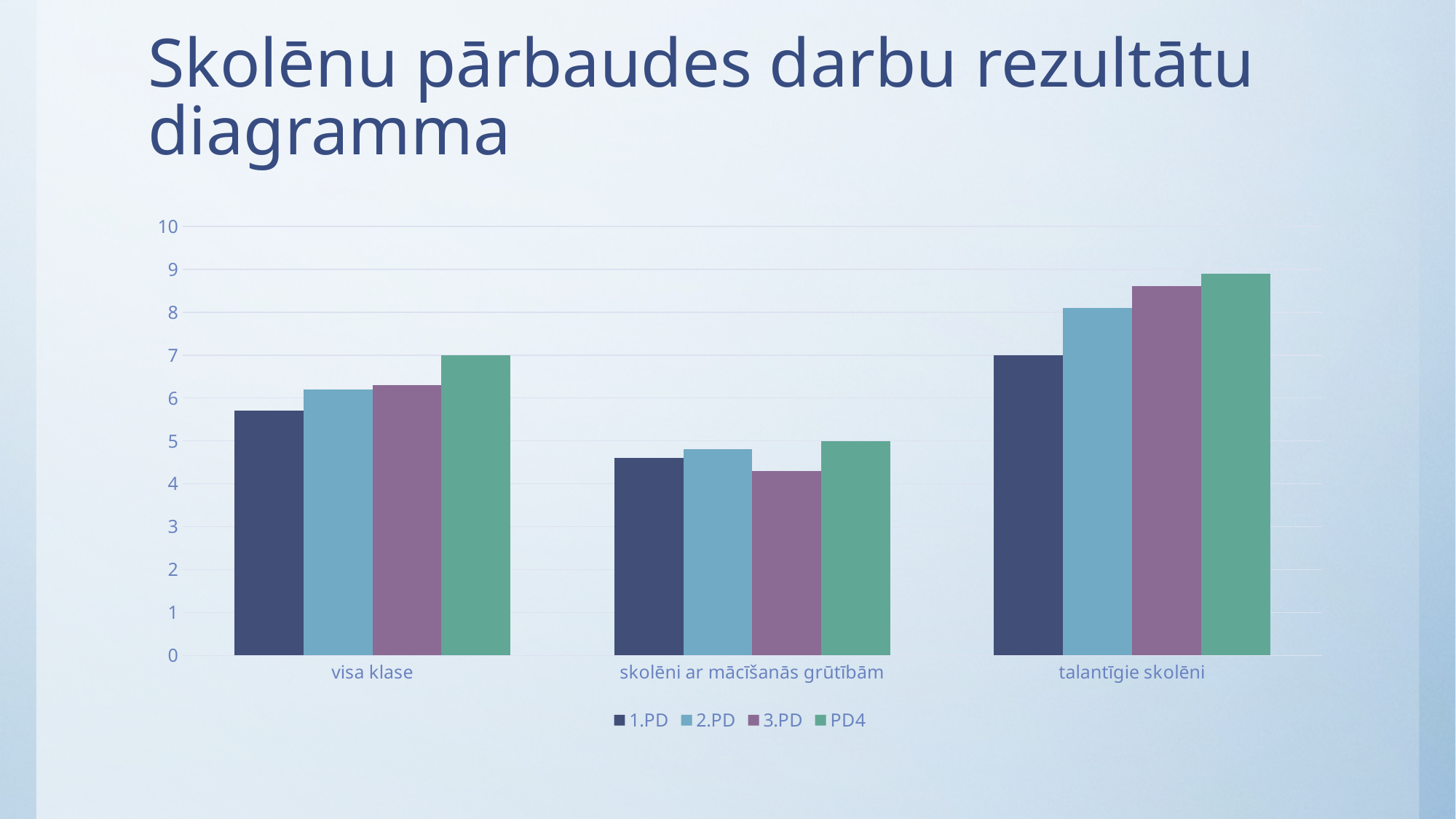
Which category has the highest PD4 value? talantīgie skolēni Is the value of 1.PD for visa klase greater or less than 6? less What is the value of PD4 for visa klase? 7 What type of chart is shown on the slide? bar chart How many series does the legend list? 4 What is the value of PD4 for skolēni ar mācīšanās grūtībām? 5 What is the value of 1.PD for talantīgie skolēni? 7 What is the title of the slide? Skolēnu pārbaudes darbu rezultātu diagramma How many categories are shown on the x axis? 3 Which category has the lowest 3.PD value? skolēni ar mācīšanās grūtībām For talantīgie skolēni, which is larger: 1.PD or 3.PD? 3.PD